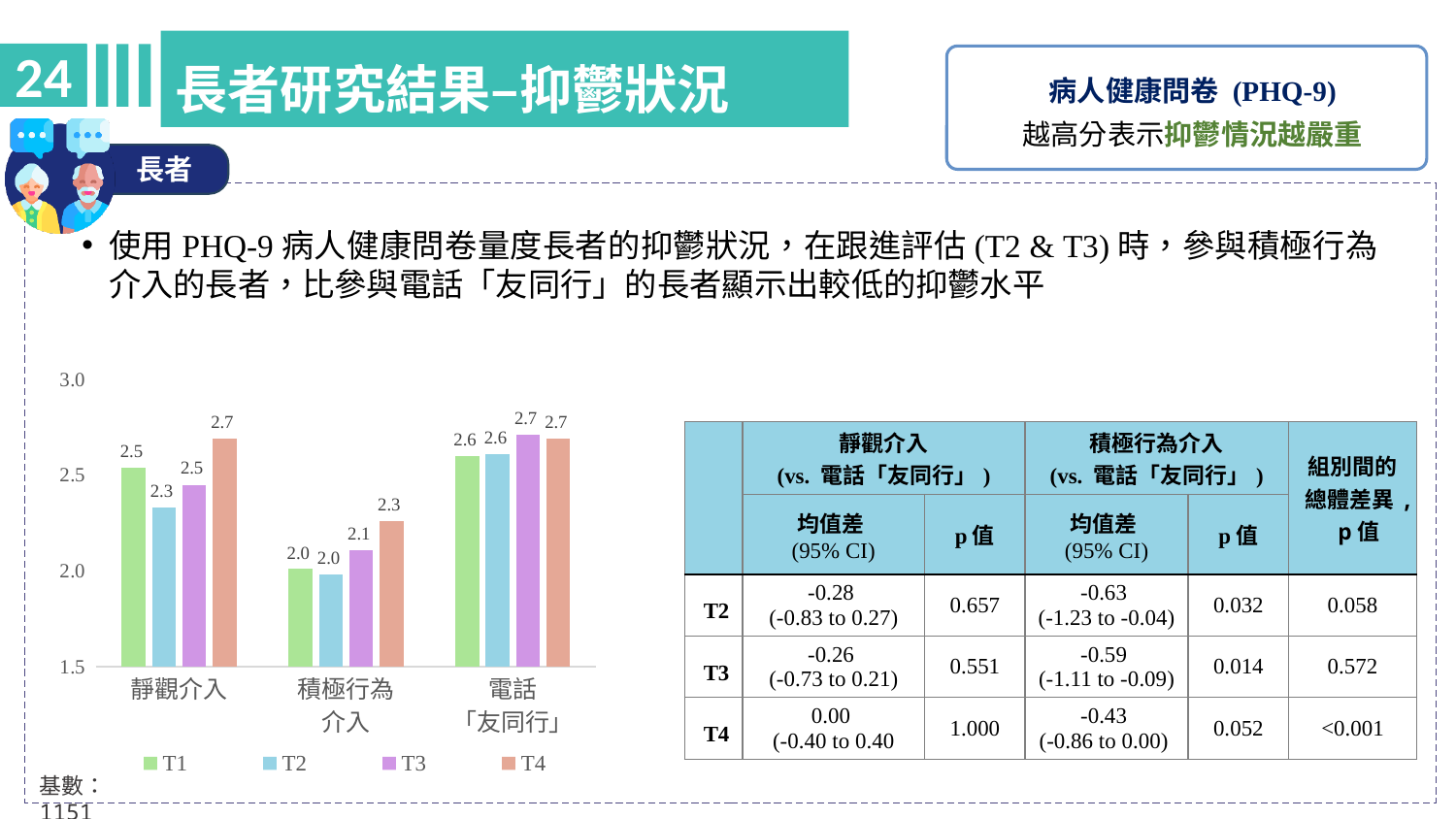
Which is larger in the bar chart: the T3 value for 靜觀介入 or the T3 value for 積極行為介入? 靜觀介入 What is the T3 value for 電話「友同行」 in the bar chart? 2.7 How many categories are shown on the x axis of the bar chart? 3 How many series does the legend of the bar chart list? 4 What is the T1 value for 靜觀介入 in the bar chart? 2.5 Which category has the highest T2 value in the bar chart? 電話「友同行」 Which category has the lowest T4 value in the bar chart? 積極行為介入 Do the values for 積極行為介入 rise or fall from T1 to T4 in the bar chart? rise What kind of chart is shown on the slide? bar chart What is the difference between the T4 and T1 values for 積極行為介入 in the bar chart? 0.3 What is the T4 value for 靜觀介入 in the bar chart? 2.7 What is the T2 value for 積極行為介入 in the bar chart? 2.0